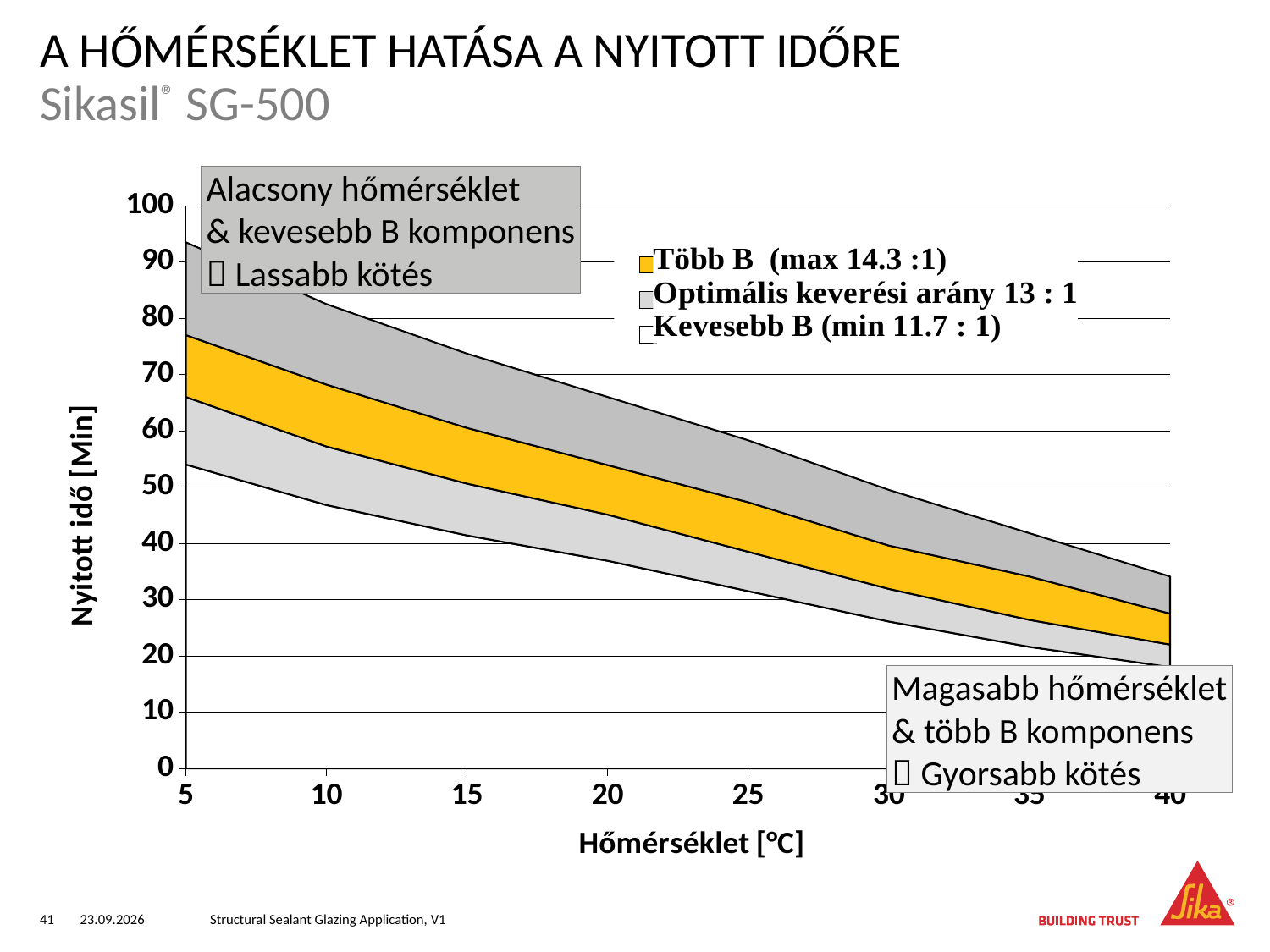
How many temperature values are labelled on the x axis? 8 Which legend entry is shown in yellow? Több B (max 14.3 :1) Is the upper edge of the shaded band at 5 °C greater or less than 80 minutes? greater How many series does the legend list? 3 What kind of chart is shown on the slide? Area chart Is the lower edge of the shaded band at 5 °C greater or less than 50 minutes? greater Is the lower edge of the shaded band at 40 °C greater or less than 30 minutes? less What is the label of the y axis? Nyitott idő [Min] Does the open time rise or fall as the temperature increases along the x axis? Fall